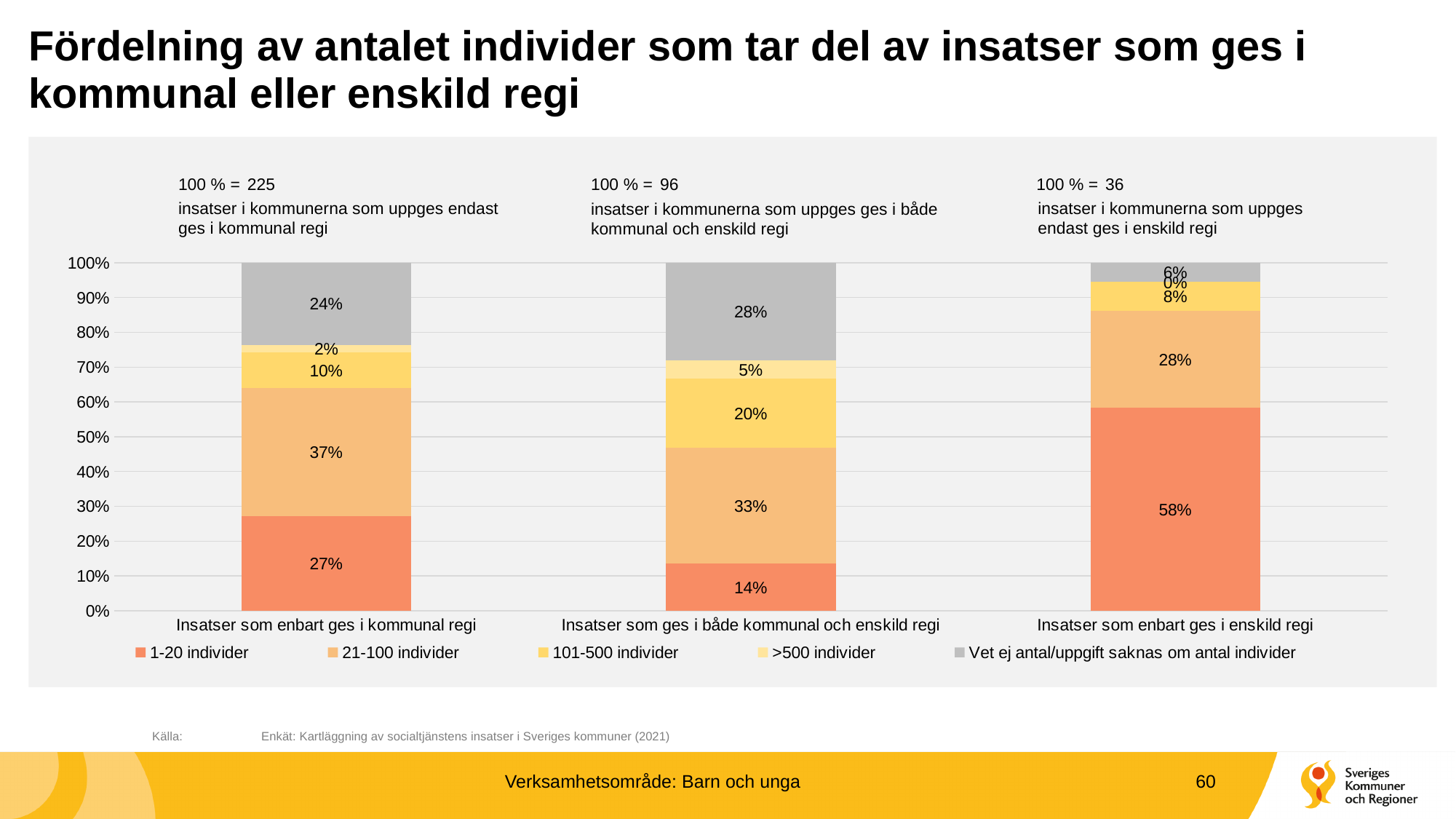
How many series does the legend list? 5 How many categories are shown on the x axis of the chart? 3 What kind of chart is shown on the slide? stacked bar chart Which is larger: the '21-100 individer' value for 'Insatser som enbart ges i kommunal regi' or for 'Insatser som ges i både kommunal och enskild regi'? Insatser som enbart ges i kommunal regi According to the text above the chart, how many insatser does 100 % correspond to for the category 'Insatser som ges i både kommunal och enskild regi'? 96 What is the value for '1-20 individer' in the category 'Insatser som enbart ges i enskild regi'? 58% What is the value for 'Vet ej antal/uppgift saknas om antal individer' in the category 'Insatser som ges i både kommunal och enskild regi'? 28% Which category has the highest value for '1-20 individer'? Insatser som enbart ges i enskild regi Which category has the lowest value for 'Vet ej antal/uppgift saknas om antal individer'? Insatser som enbart ges i enskild regi What is the difference between the '1-20 individer' values for 'Insatser som enbart ges i enskild regi' and 'Insatser som enbart ges i kommunal regi'? 31 percentage points What is the value for '21-100 individer' in the category 'Insatser som enbart ges i kommunal regi'? 37% What is the value for '101-500 individer' in the category 'Insatser som ges i både kommunal och enskild regi'? 20%